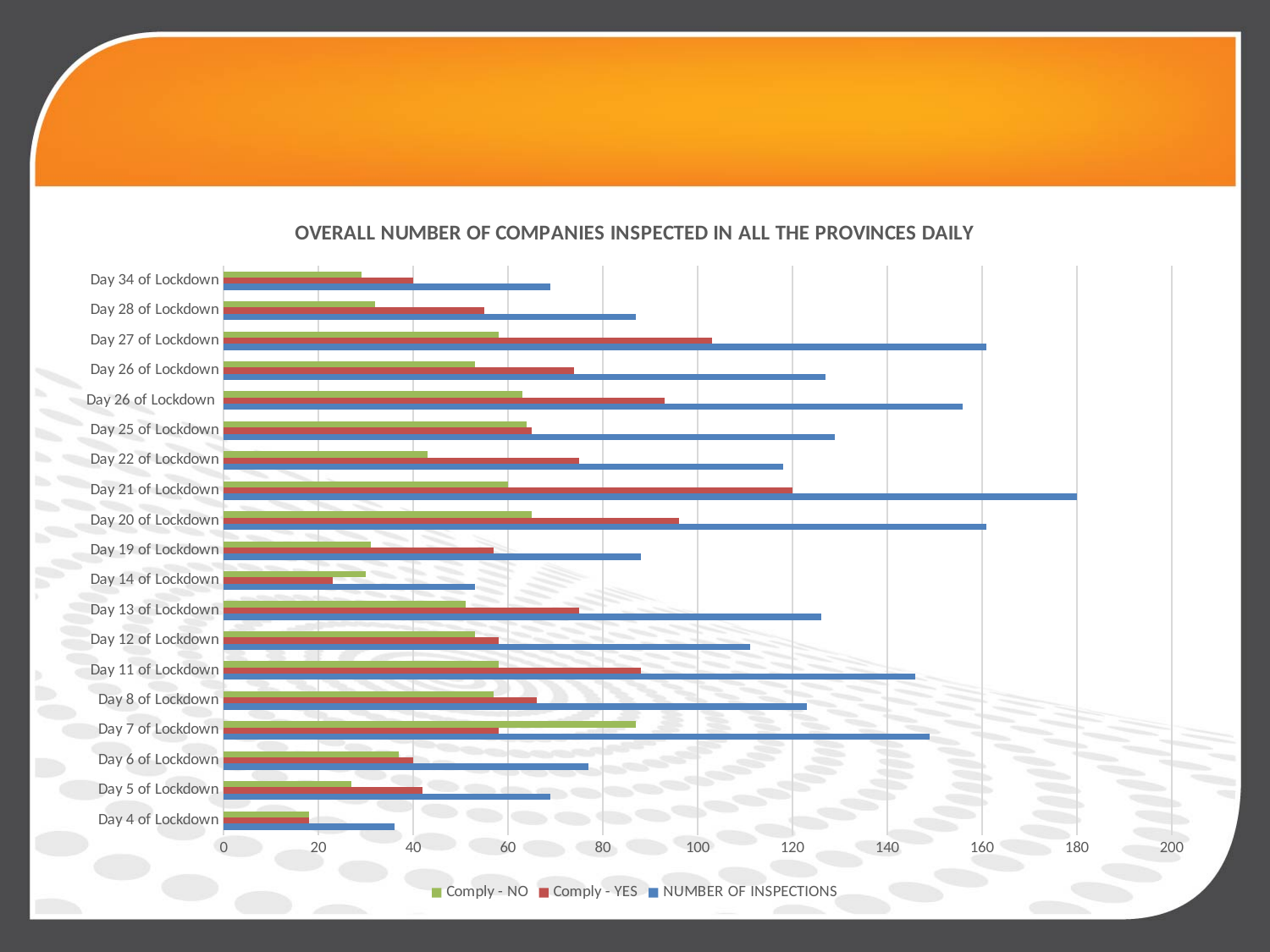
Is the NUMBER OF INSPECTIONS for Day 4 of Lockdown greater or less than 40? less Which day has the lowest NUMBER OF INSPECTIONS? Day 4 of Lockdown Which day has the highest NUMBER OF INSPECTIONS? Day 21 of Lockdown Is the NUMBER OF INSPECTIONS for Day 21 of Lockdown greater or less than 160? greater Is the Comply - YES value for Day 14 of Lockdown greater or less than 40? less What is the title of the chart? OVERALL NUMBER OF COMPANIES INSPECTED IN ALL THE PROVINCES DAILY What kind of chart is shown on the slide? Bar chart Which day has the highest Comply - NO value? Day 7 of Lockdown How many series does the legend list? 3 How many lockdown days (categories) are plotted on the chart? 19 Which is larger for Day 7 of Lockdown: Comply - NO or Comply - YES? Comply - NO Which day has the highest Comply - YES value? Day 21 of Lockdown